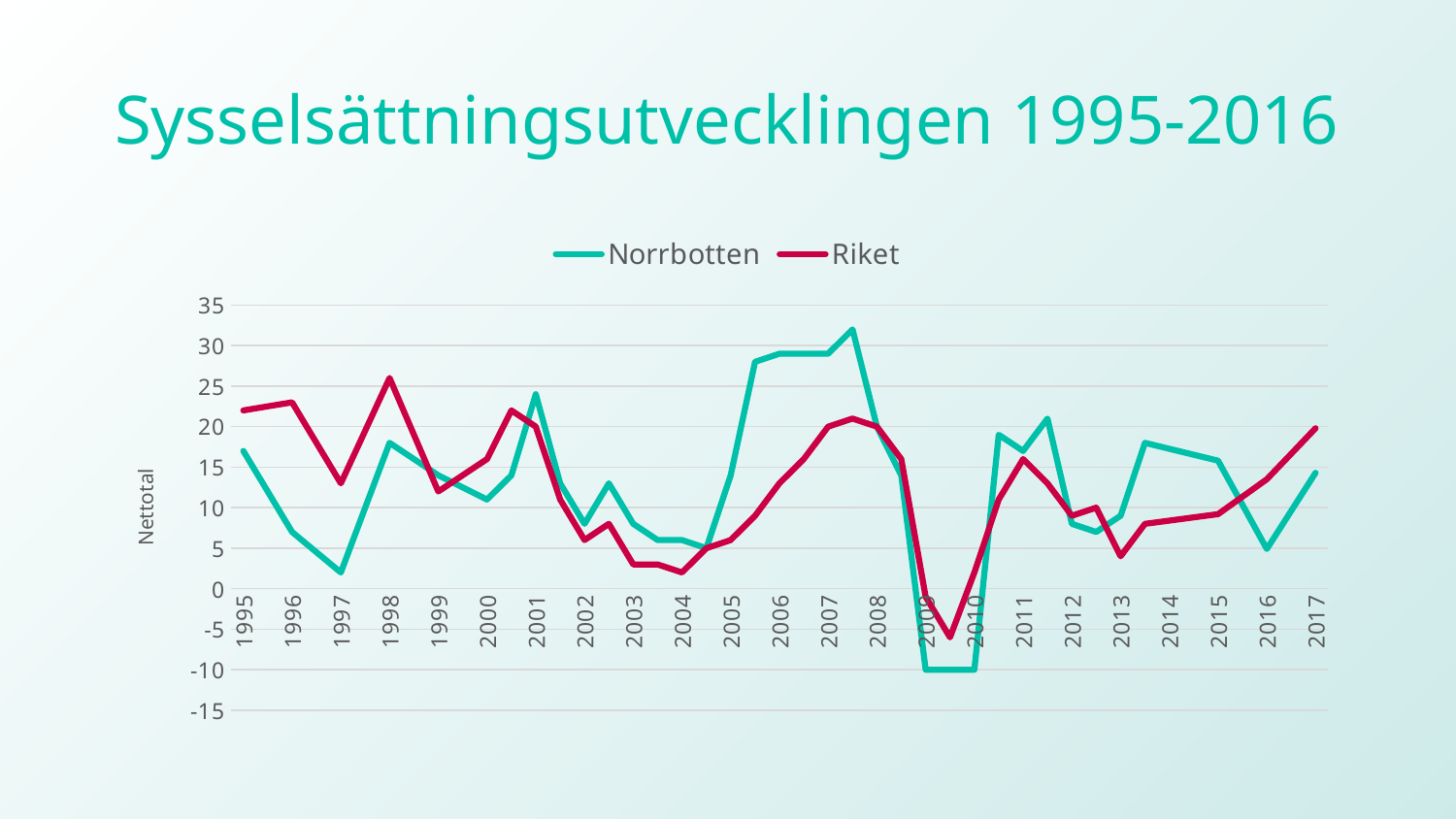
What is the label on the y axis? Nettotal In 2006, which series has the higher value, Norrbotten or Riket? Norrbotten In which year does the Norrbotten line reach its highest value? 2007 How many series does the legend list? 2 In 1996, which series has the higher value, Norrbotten or Riket? Riket How many years are plotted along the x axis? 23 Is the value for Riket in 2004 greater or less than 5? less Is the value for Norrbotten in 2009 greater or less than 0? less What kind of chart is shown on the slide? line chart In which year does the Riket line reach its lowest value? 2009 What is the title of the chart? Sysselsättningsutvecklingen 1995-2016